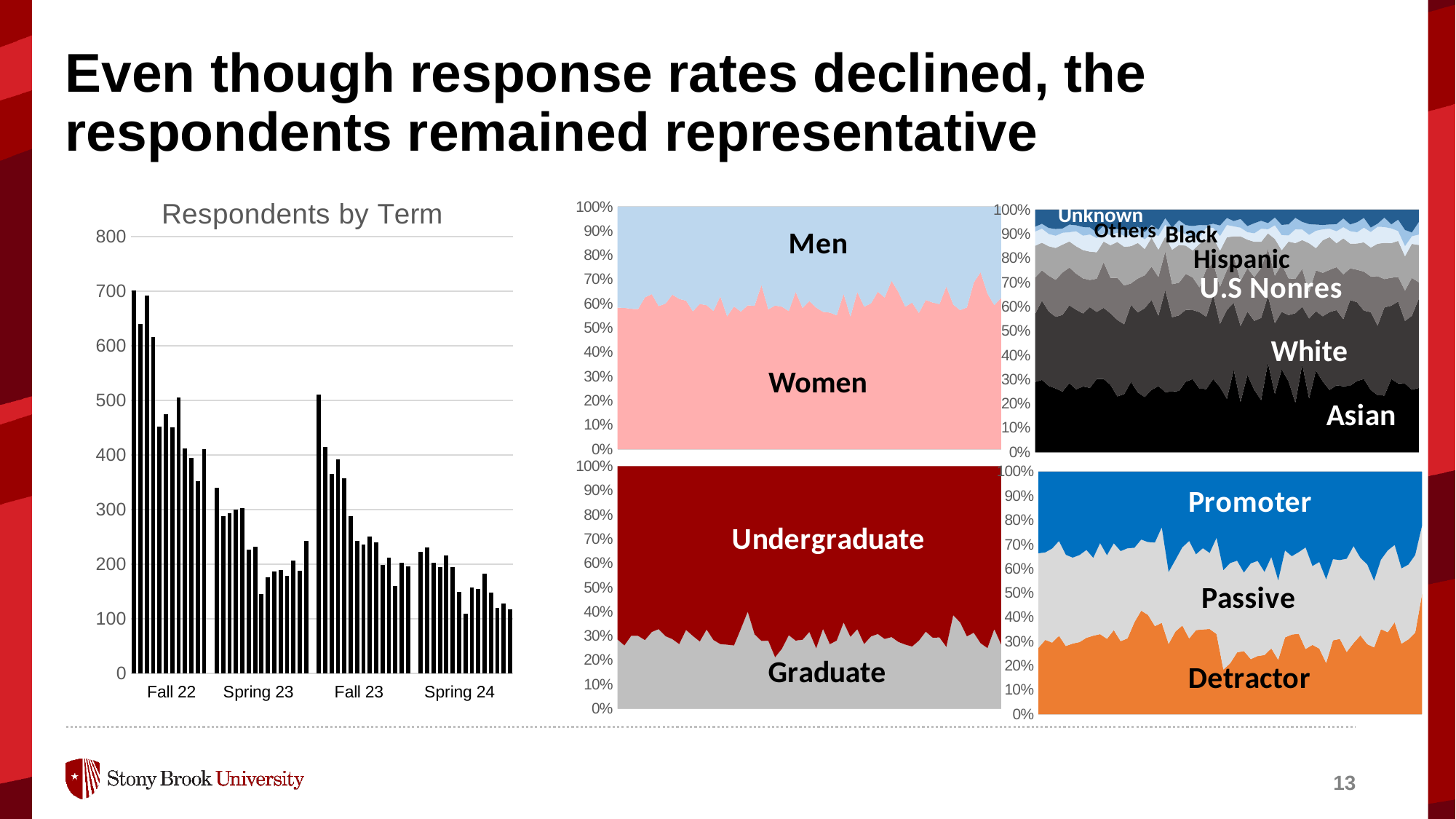
In the race/ethnicity chart (top right), which group forms the bottom layer of the stack? Asian How many groups are labelled in the race/ethnicity area chart (top right)? 7 In the Men/Women chart (top middle), which group has the larger share throughout? Women In the "Respondents by Term" chart, is the value of the last bar greater or less than 200? less What is the title of the bar chart on the left of the slide? Respondents by Term In the Promoter/Passive/Detractor chart (bottom right), is the share for Promoter greater or less than 50%? less What kind of chart is the "Respondents by Term" chart? bar chart How many term labels are shown on the x axis of the "Respondents by Term" chart? 4 In the "Respondents by Term" chart, is the value of the first (tallest) bar greater or less than 600? greater In the "Respondents by Term" chart, do the bar heights generally rise or fall from Fall 22 to Spring 24? fall